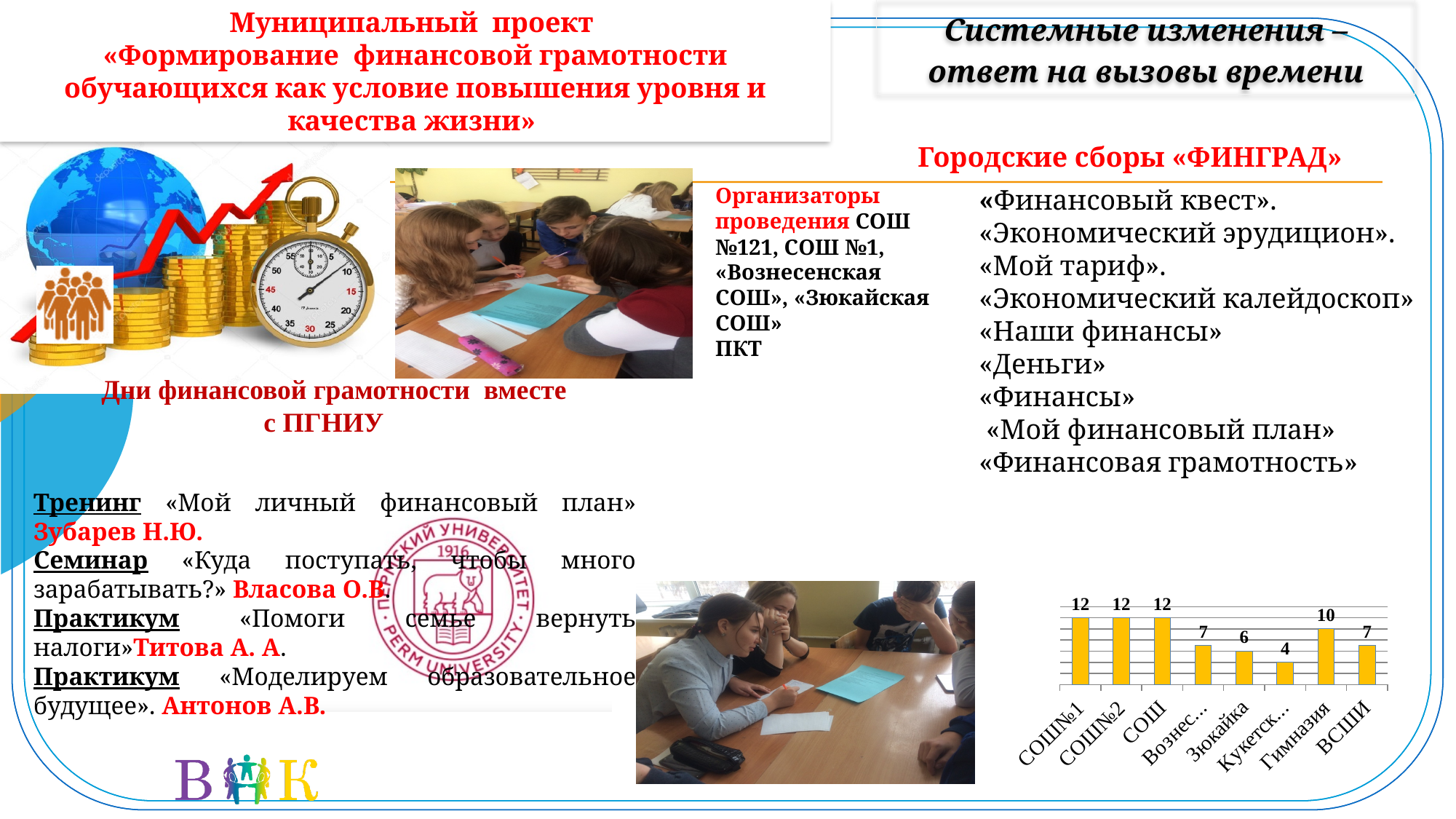
What is the value for Зюкайка in the bar chart? 6 What is the difference between the values for Гимназия and Зюкайка in the bar chart? 4 What colour are the bars in the bar chart? yellow What is the value for Гимназия in the bar chart? 10 What is the highest value shown in the bar chart? 12 How many categories are shown in the bar chart? 8 Which category has the lowest value in the bar chart? Кукетск… Which is larger in the bar chart, the value for Гимназия or the value for ВСШИ? Гимназия What is the difference between the values for СОШ№2 and ВСШИ in the bar chart? 5 What is the value for ВСШИ in the bar chart? 7 What type of chart is shown at the bottom right of the slide? bar chart What is the value for СОШ№1 in the bar chart? 12